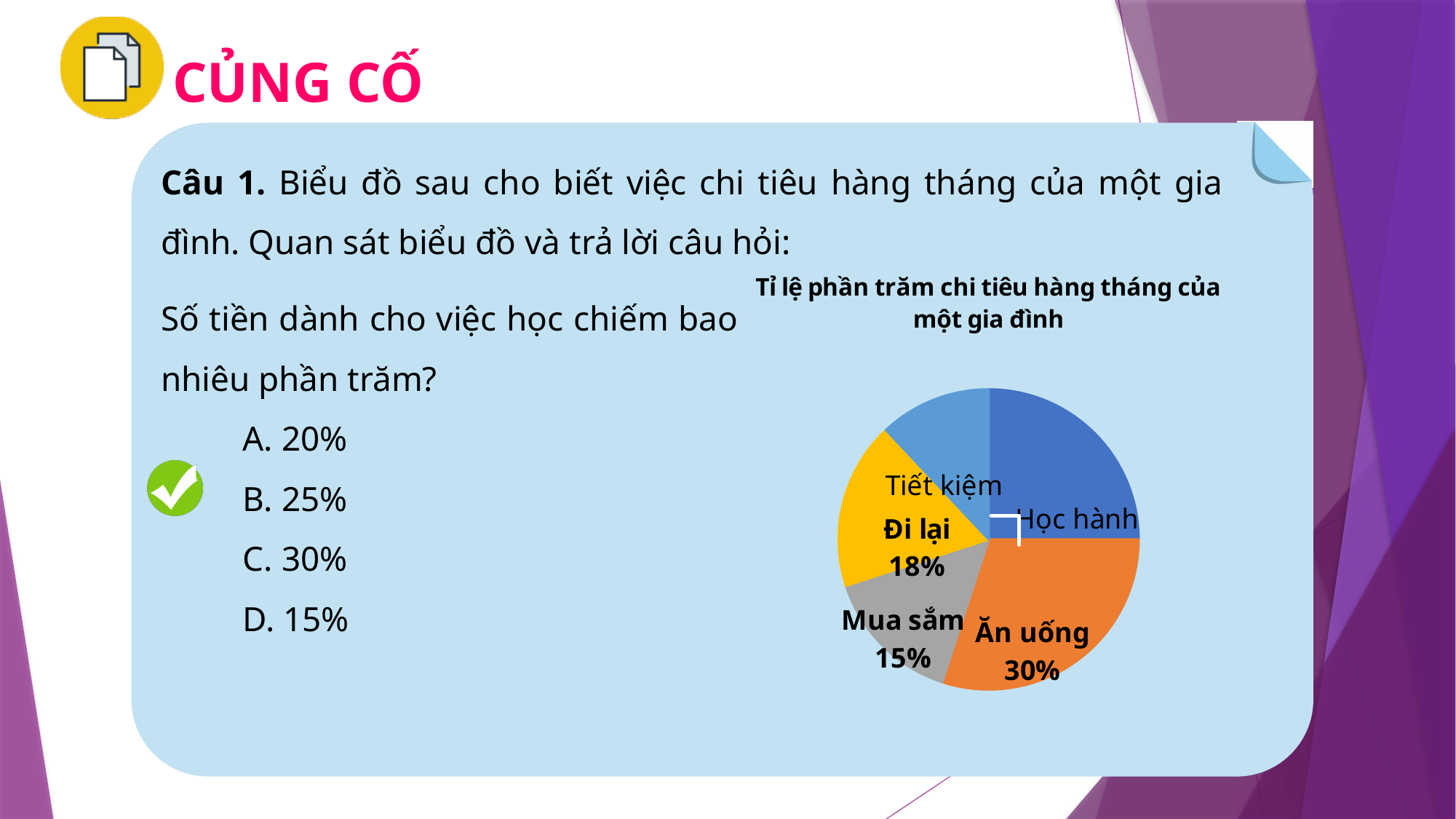
What is the title of the pie chart? Tỉ lệ phần trăm chi tiêu hàng tháng của một gia đình How many slices does the pie chart have? 5 Which is larger, Đi lại or Mua sắm? Đi lại What is the difference between the Đi lại and Mua sắm percentages? 3% What colour is the Ăn uống slice? orange What percentage is shown for Ăn uống? 30% What percentage is shown for Mua sắm? 15% Which is larger, Ăn uống or Đi lại? Ăn uống Which slice of the pie chart is the largest? Ăn uống What percentage is shown for Đi lại? 18% What kind of chart is shown on the slide? pie chart What is the difference between the Ăn uống and Mua sắm percentages? 15%